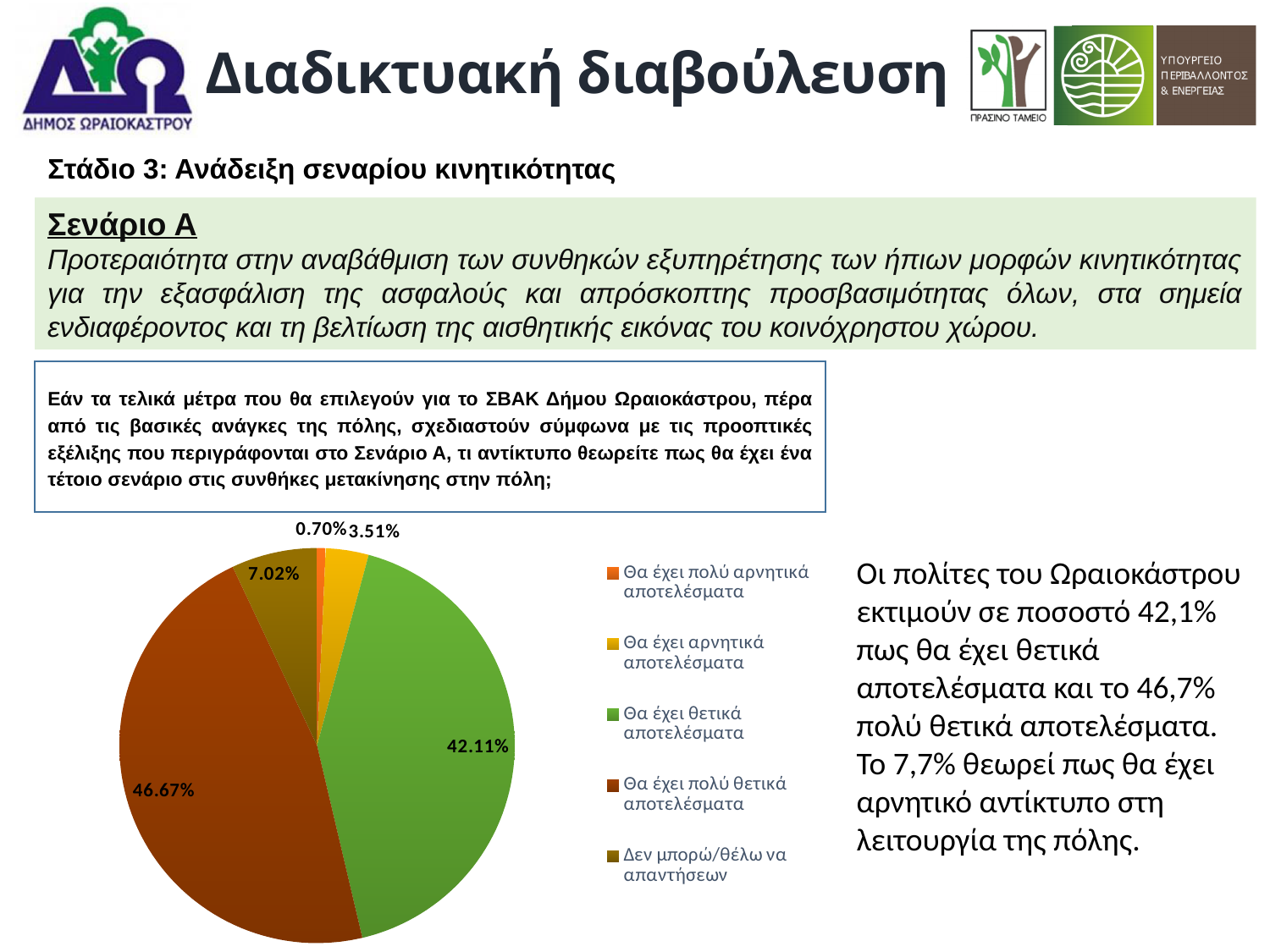
What share of respondents answered "Θα έχει θετικά αποτελέσματα"? 42.11% Which is larger: the share for "Δεν μπορώ/θέλω να απαντήσεων" or the share for "Θα έχει αρνητικά αποτελέσματα"? Δεν μπορώ/θέλω να απαντήσεων What kind of chart is shown on the slide? pie chart Which response has the smallest share of the pie? Θα έχει πολύ αρνητικά αποτελέσματα What is the difference in percentage points between "Θα έχει πολύ θετικά αποτελέσματα" and "Θα έχει θετικά αποτελέσματα"? 4.56 What share of respondents answered "Θα έχει πολύ αρνητικά αποτελέσματα"? 0.70% What colour is the slice for "Θα έχει θετικά αποτελέσματα"? green What share of respondents answered "Θα έχει πολύ θετικά αποτελέσματα"? 46.67% How many slices does the pie chart have? 5 Which response has the largest share of the pie? Θα έχει πολύ θετικά αποτελέσματα What share of respondents answered "Θα έχει αρνητικά αποτελέσματα"? 3.51% What share of respondents answered "Δεν μπορώ/θέλω να απαντήσεων"? 7.02%